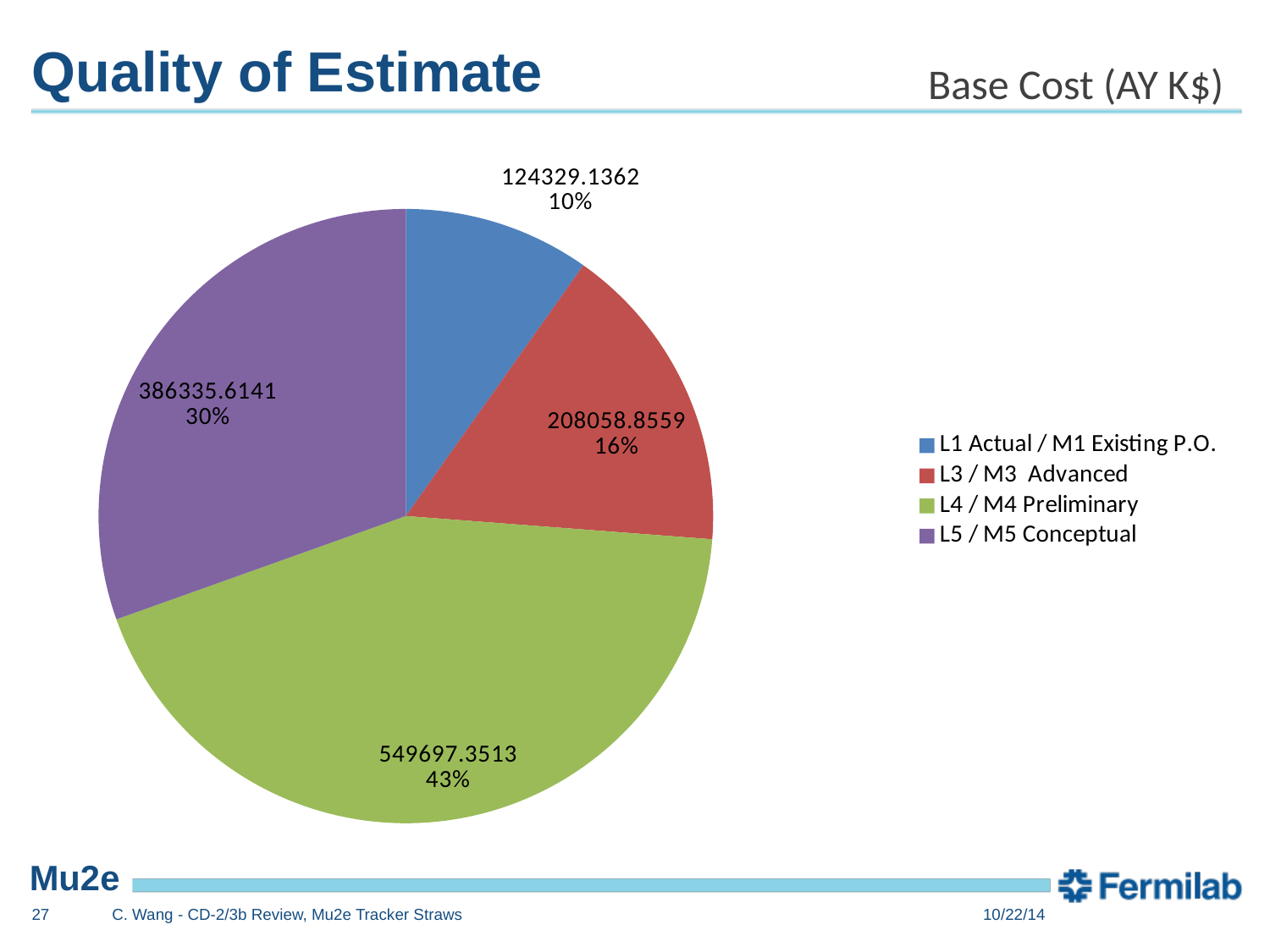
How many categories does the legend list? 4 What is the difference between the values for L3 / M3 Advanced and L1 Actual / M1 Existing P.O.? 83729.7197 Which category has the largest slice? L4 / M4 Preliminary What is the value for L3 / M3 Advanced? 208058.8559 What type of chart is shown on the slide? pie chart Which category has the smallest slice? L1 Actual / M1 Existing P.O. What is the value for L5 / M5 Conceptual? 386335.6141 What share of the pie does L5 / M5 Conceptual represent? 30% What is the value for L1 Actual / M1 Existing P.O.? 124329.1362 Which is larger, L3 / M3 Advanced or L5 / M5 Conceptual? L5 / M5 Conceptual What is the value for L4 / M4 Preliminary? 549697.3513 What share of the pie does L4 / M4 Preliminary represent? 43%